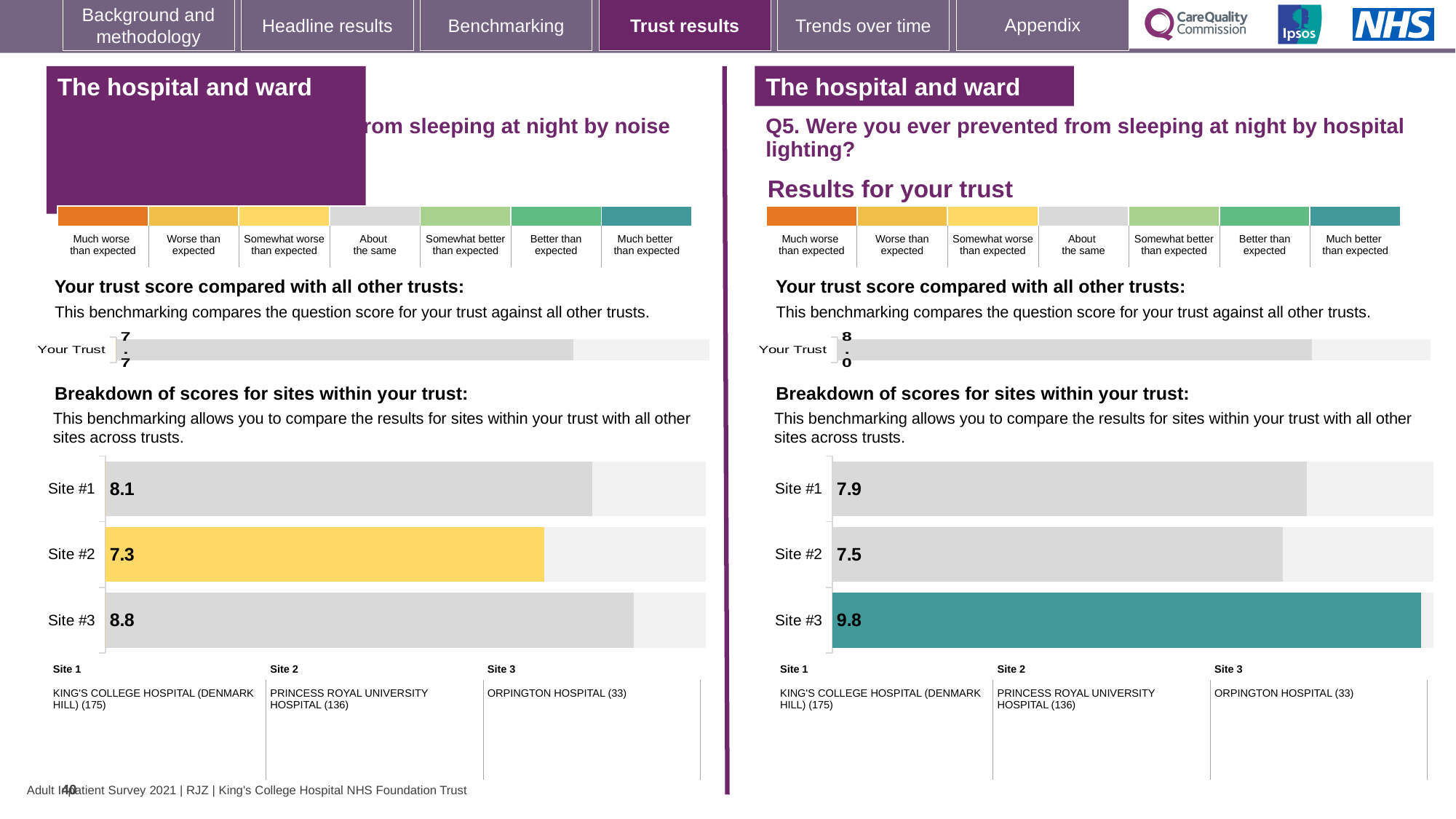
On the right-hand 'Breakdown of scores for sites within your trust' chart (Q5, hospital lighting), what is the difference between the scores for Site #3 and Site #1? 1.9 Comparing the two 'Breakdown of scores for sites within your trust' charts, is the Site #1 score higher on the left-hand chart or the right-hand chart? Left-hand chart On the left-hand 'Breakdown of scores for sites within your trust' chart, what is the score for Site #2? 7.3 On the left-hand 'Breakdown of scores for sites within your trust' chart, which site has the lowest score? Site #2 On the left-hand 'Breakdown of scores for sites within your trust' chart, what is the difference between the scores for Site #3 and Site #2? 1.5 On the left-hand 'Breakdown of scores for sites within your trust' chart, which site has the highest score? Site #3 What type of chart is the right-hand 'Breakdown of scores for sites within your trust' chart? Bar chart On the right-hand 'Breakdown of scores for sites within your trust' chart (Q5, hospital lighting), what is the score for Site #2? 7.5 How many sites are shown on the right-hand 'Breakdown of scores for sites within your trust' chart? 3 On the left-hand 'Breakdown of scores for sites within your trust' chart, what is the score for Site #1? 8.1 On the right-hand 'Breakdown of scores for sites within your trust' chart (Q5, hospital lighting), which site has the lowest score? Site #2 On the right-hand 'Breakdown of scores for sites within your trust' chart (Q5, hospital lighting), what is the score for Site #3? 9.8